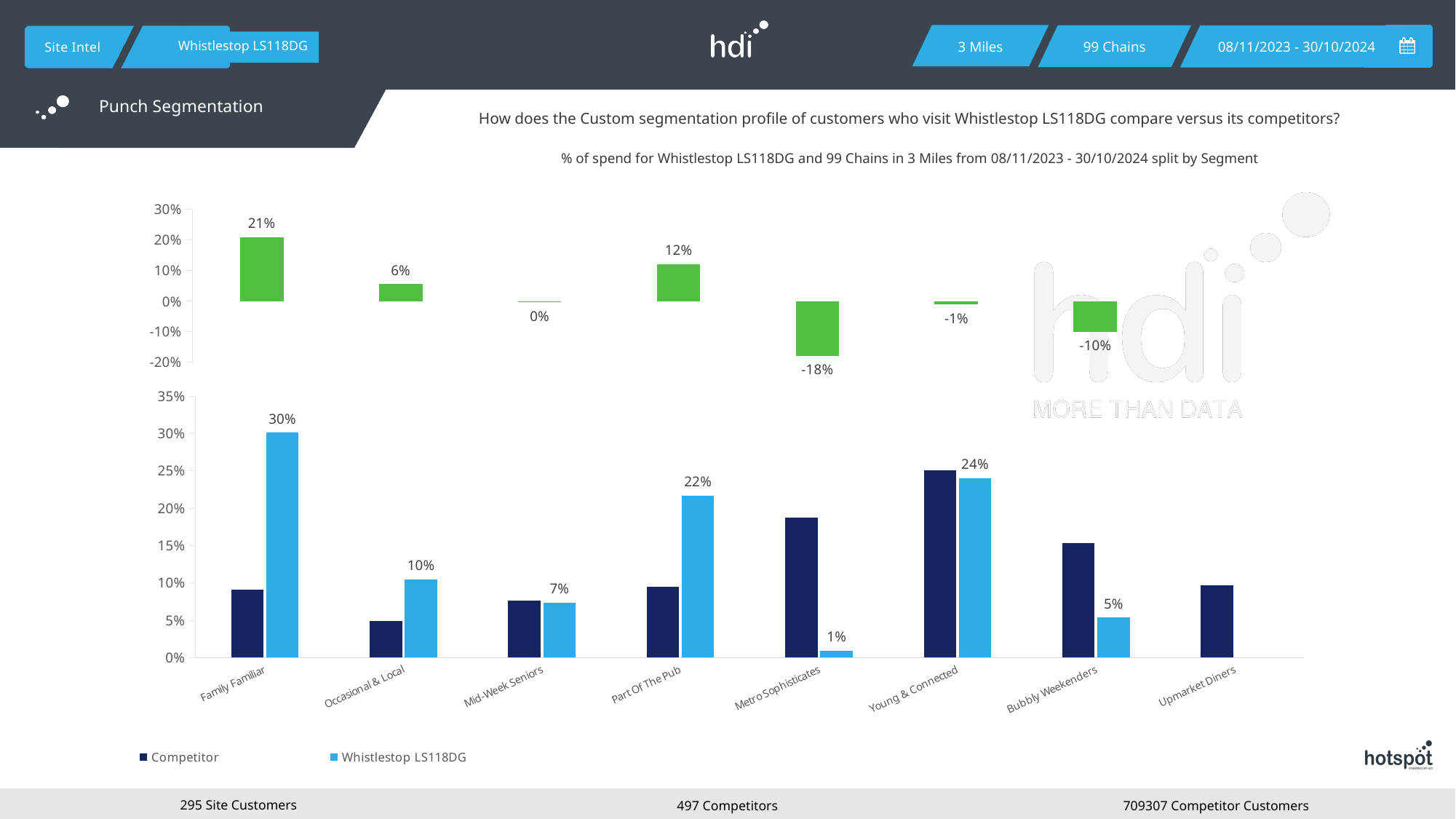
In the top chart, which segment has the lowest value? Metro Sophisticates In the bottom chart, what is the Whistlestop LS118DG value for Part Of The Pub? 22% How many series does the legend of the bottom chart list? 2 In the bottom chart, what is the difference between the Whistlestop LS118DG values for Family Familiar and Occasional & Local? 20 percentage points What kind of chart is the bottom chart? Bar chart In the top chart, what is the value shown for Metro Sophisticates? -18% In the top chart, which segment has the highest value? Family Familiar How many segment categories are shown on the x axis of the bottom chart? 8 In the bottom chart, what is the Whistlestop LS118DG value for Family Familiar? 30% In the bottom chart, which segment has the highest Whistlestop LS118DG value? Family Familiar In the bottom chart, for Metro Sophisticates, which is larger: the Competitor value or the Whistlestop LS118DG value? Competitor In the bottom chart, is the Competitor value for Young & Connected greater or less than 20%? greater